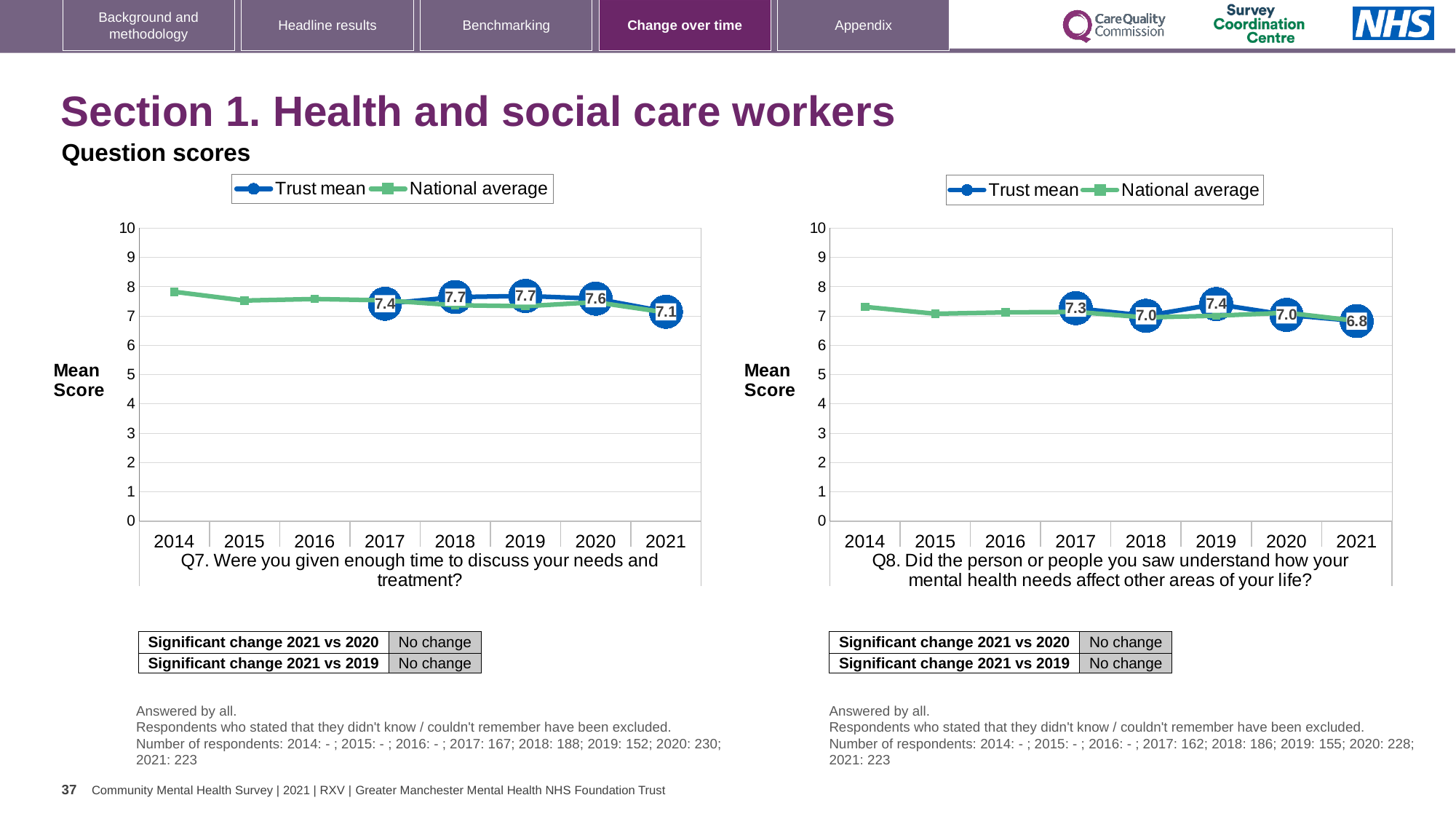
In the Q7 chart on the left, what is the Trust mean for 2017? 7.4 In the Q7 chart on the left, what is the difference between the Trust mean in 2019 and in 2021? 0.6 In the Q8 chart on the right, which is larger, the Trust mean for 2017 or for 2018? 2017 In the Q8 chart on the right, what is the Trust mean for 2019? 7.4 In the Q8 chart on the right, which year has the highest Trust mean? 2019 In the Q7 chart on the left, what is the Trust mean for 2021? 7.1 In the Q8 chart on the right, what is the Trust mean for 2021? 6.8 In the Q7 chart on the left, which year has the lowest labelled Trust mean? 2021 How many years are shown on the x axis of the Q8 chart on the right? 8 In the Q7 chart on the left, is the National average for 2014 greater or less than 7? greater What kind of chart is the Q8 chart on the right? Line chart How many series does the legend of the Q7 chart on the left list? 2